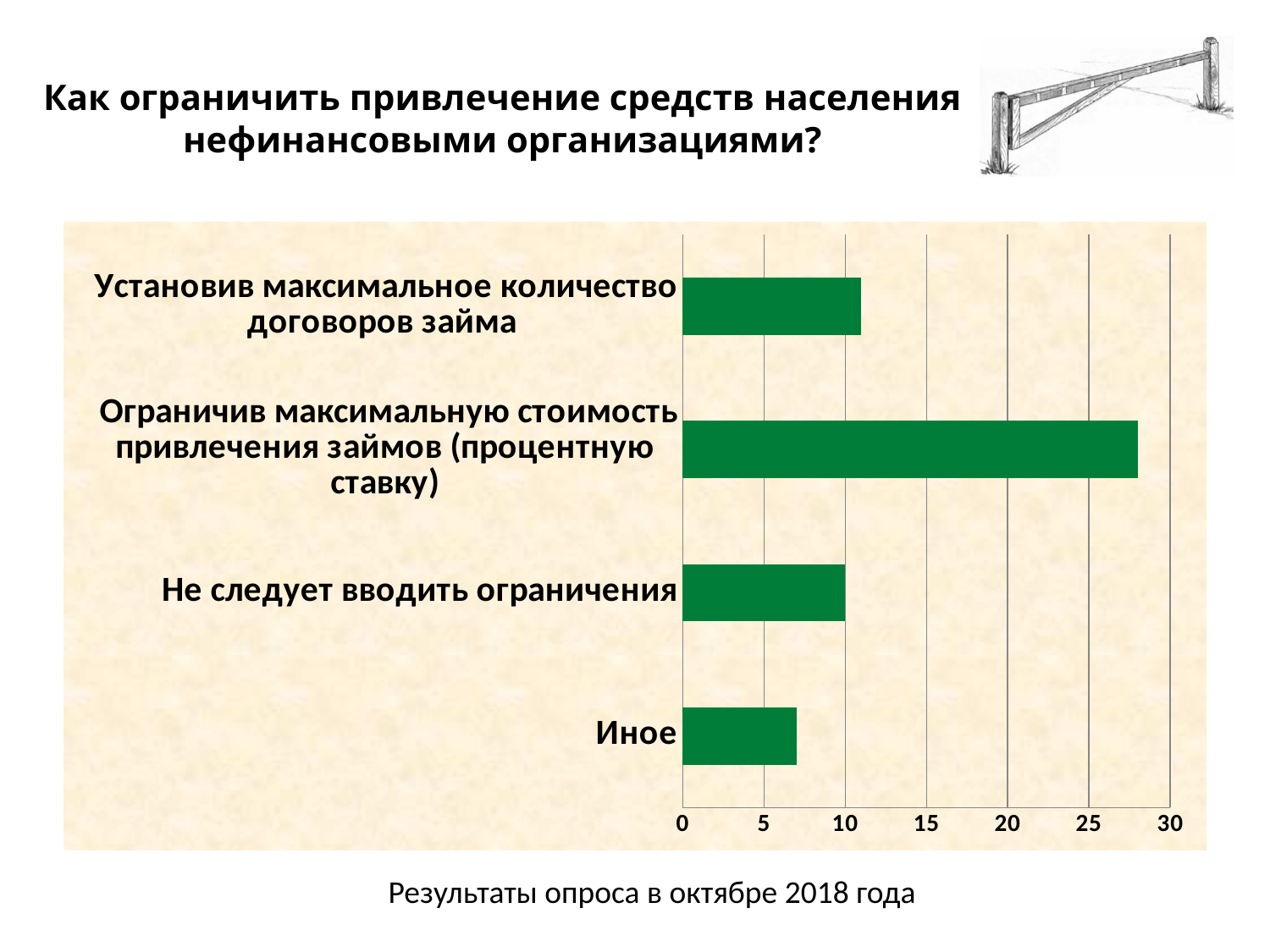
How many categories are plotted in the chart? 4 Is the value for "Иное" greater or less than 10? less According to the caption below the chart, when was the survey conducted? В октябре 2018 года What is the maximum value shown on the horizontal axis? 30 Which category has the lowest value? Иное What kind of chart is shown on the slide? Bar chart Which is larger: the value for "Установив максимальное количество договоров займа" or the value for "Иное"? Установив максимальное количество договоров займа Is the value for "Иное" greater or less than 5? greater Which category has the highest value? Ограничив максимальную стоимость привлечения займов (процентную ставку) Is the value for "Установив максимальное количество договоров займа" greater or less than 15? less What is the value for "Не следует вводить ограничения"? 10